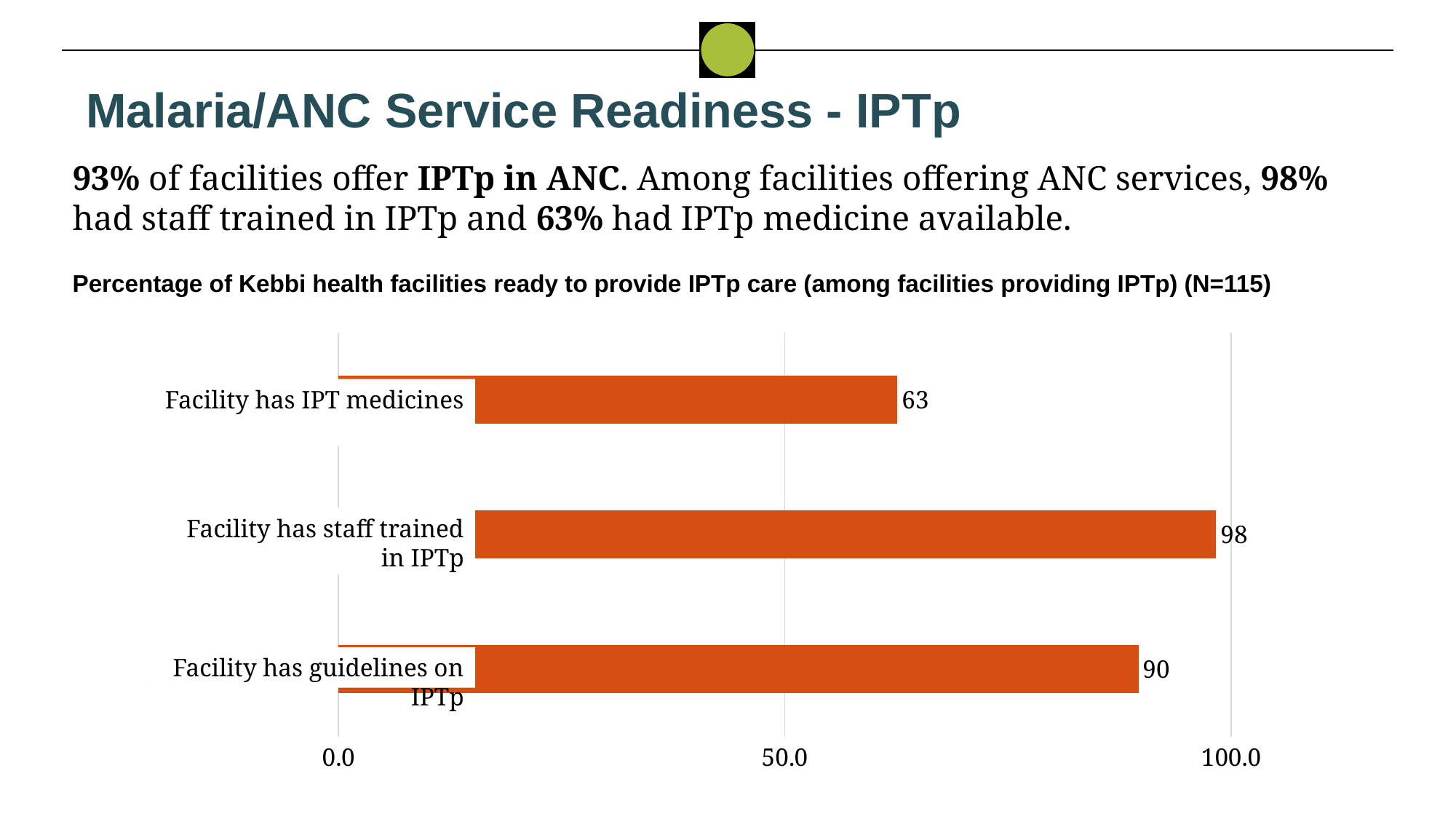
What kind of chart is shown on the slide? bar chart Is the value for 'Facility has IPT medicines' greater or less than 50.0? greater What is the difference between the values for 'Facility has staff trained in IPTp' and 'Facility has IPT medicines'? 35 What is the value for 'Facility has staff trained in IPTp'? 98 What is the title of the chart? Percentage of Kebbi health facilities ready to provide IPTp care (among facilities providing IPTp) (N=115) What is the value for 'Facility has guidelines on IPTp'? 90 Which category has the lowest value? Facility has IPT medicines What is the difference between the values for 'Facility has guidelines on IPTp' and 'Facility has IPT medicines'? 27 How many categories are shown in the chart? 3 What is the value for 'Facility has IPT medicines'? 63 Which category has the highest value? Facility has staff trained in IPTp Which is larger: the value for 'Facility has guidelines on IPTp' or 'Facility has staff trained in IPTp'? Facility has staff trained in IPTp